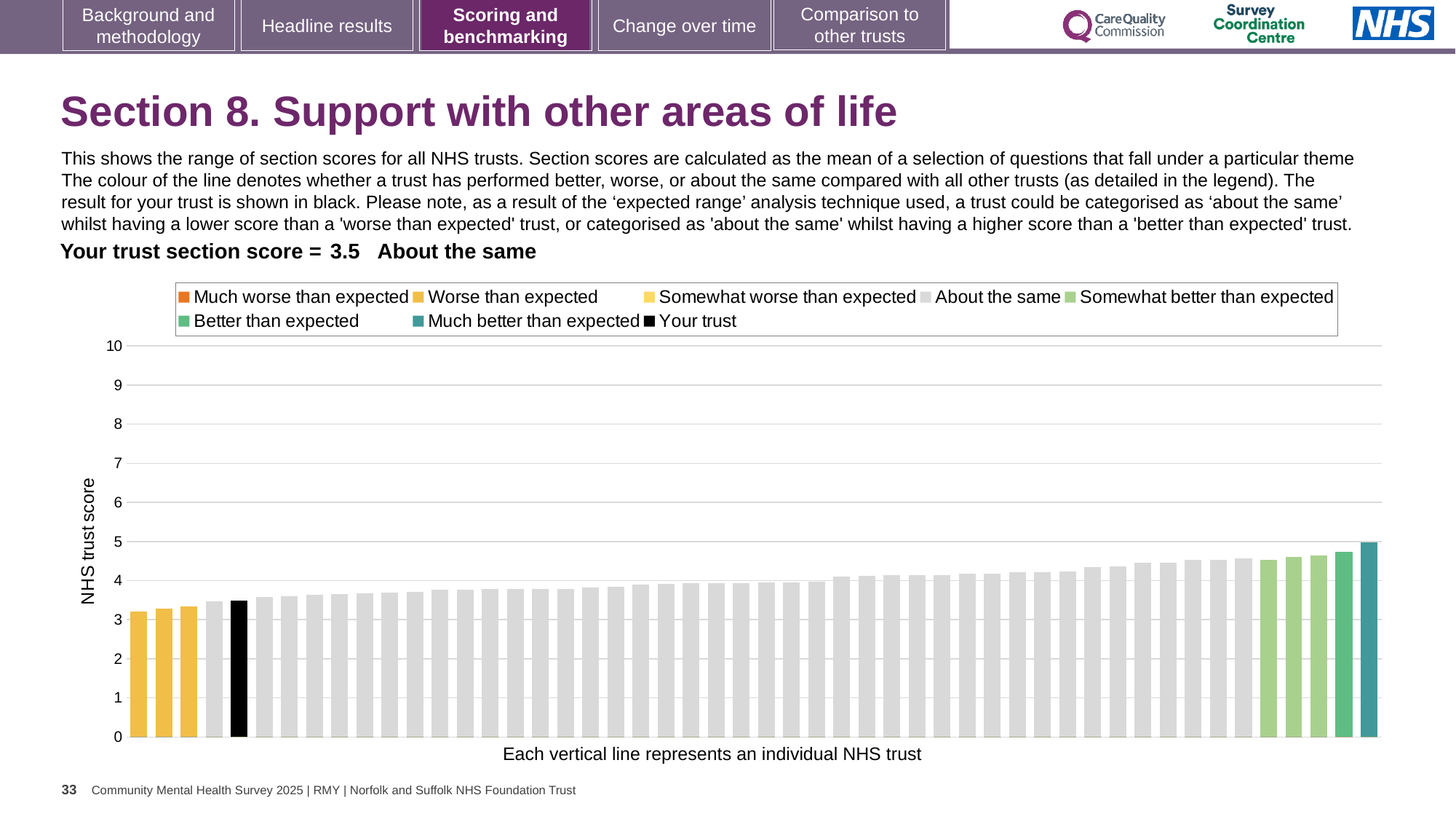
Which legend category does the tallest bar on the chart belong to? Much better than expected Which legend category do the lowest bars on the chart belong to? Worse than expected What is the label on the vertical axis of the chart? NHS trust score How many entries does the chart legend list? 8 What colour is used for the 'Your trust' bar in the chart? Black Is the value of the tallest bar on the chart greater or less than 4? greater How is your trust's section score categorised compared with other trusts? About the same What kind of chart is shown on the slide? Bar chart Is the value of the black 'Your trust' bar greater or less than 4? less What is the section score for your trust shown on the slide? 3.5 Do the bar values rise or fall from left to right along the x axis? Rise Is the value of the lowest bar on the chart greater or less than 3? greater